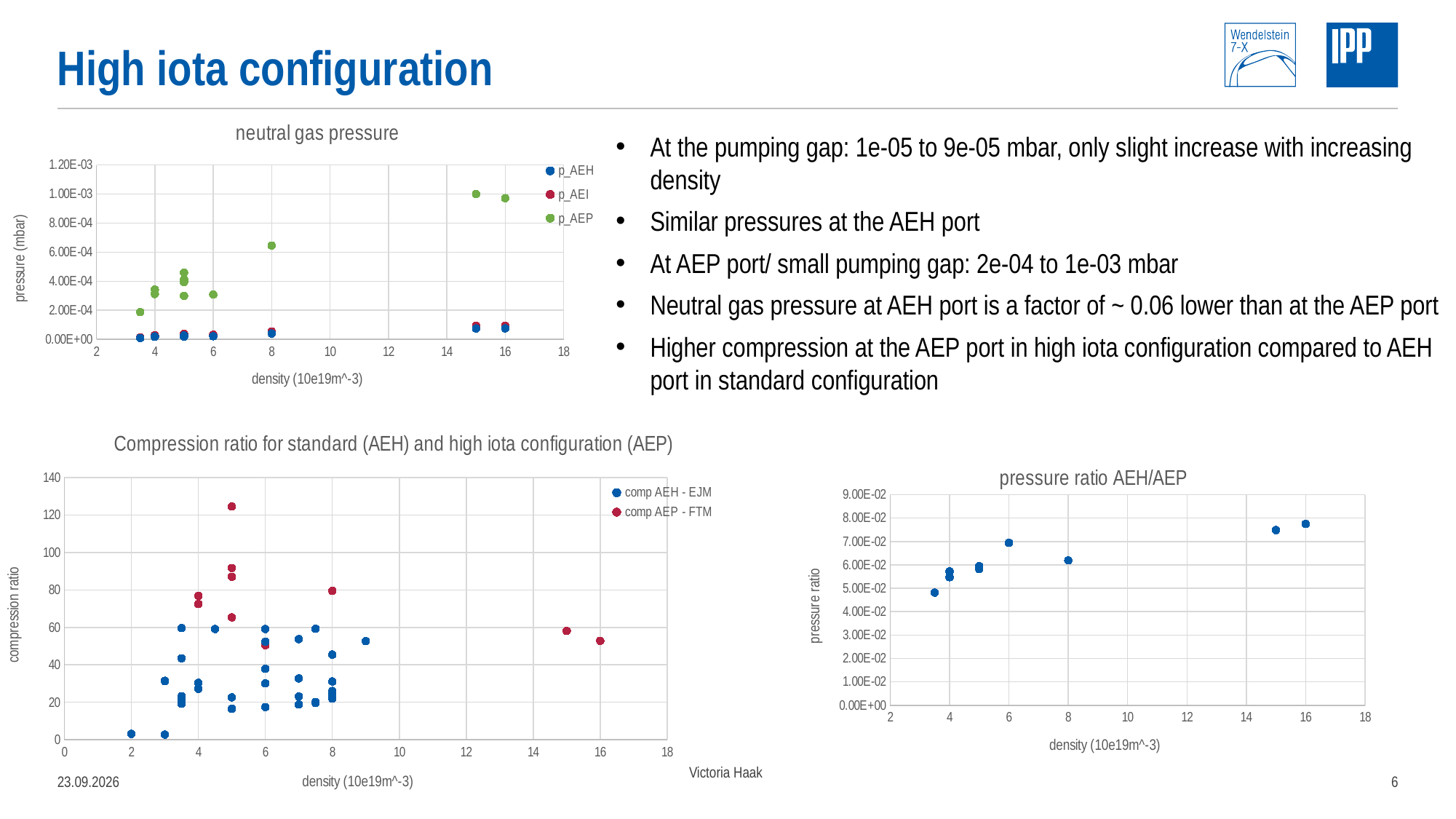
What are the legend entries of the 'neutral gas pressure' chart? p_AEH, p_AEI, p_AEP In the 'neutral gas pressure' chart, is the p_AEP value at density 8 greater or less than 4.00E-04? greater In the 'Compression ratio for standard (AEH) and high iota configuration (AEP)' chart, which comp AEP - FTM value is larger: the one at density 15 or the one at density 16? density 15 In the 'neutral gas pressure' chart, is the p_AEP value at density 15 greater or less than 8.00E-04? greater In the 'pressure ratio AEH/AEP' chart, do the values generally rise or fall as density increases? rise What are the legend entries of the 'Compression ratio for standard (AEH) and high iota configuration (AEP)' chart? comp AEH - EJM, comp AEP - FTM How many series does the legend of the 'neutral gas pressure' chart list? 3 In the 'Compression ratio for standard (AEH) and high iota configuration (AEP)' chart, is the comp AEP - FTM value at density 16 greater or less than 60? less What kind of chart is the 'neutral gas pressure' chart? scatter chart How many series does the legend of the 'Compression ratio for standard (AEH) and high iota configuration (AEP)' chart list? 2